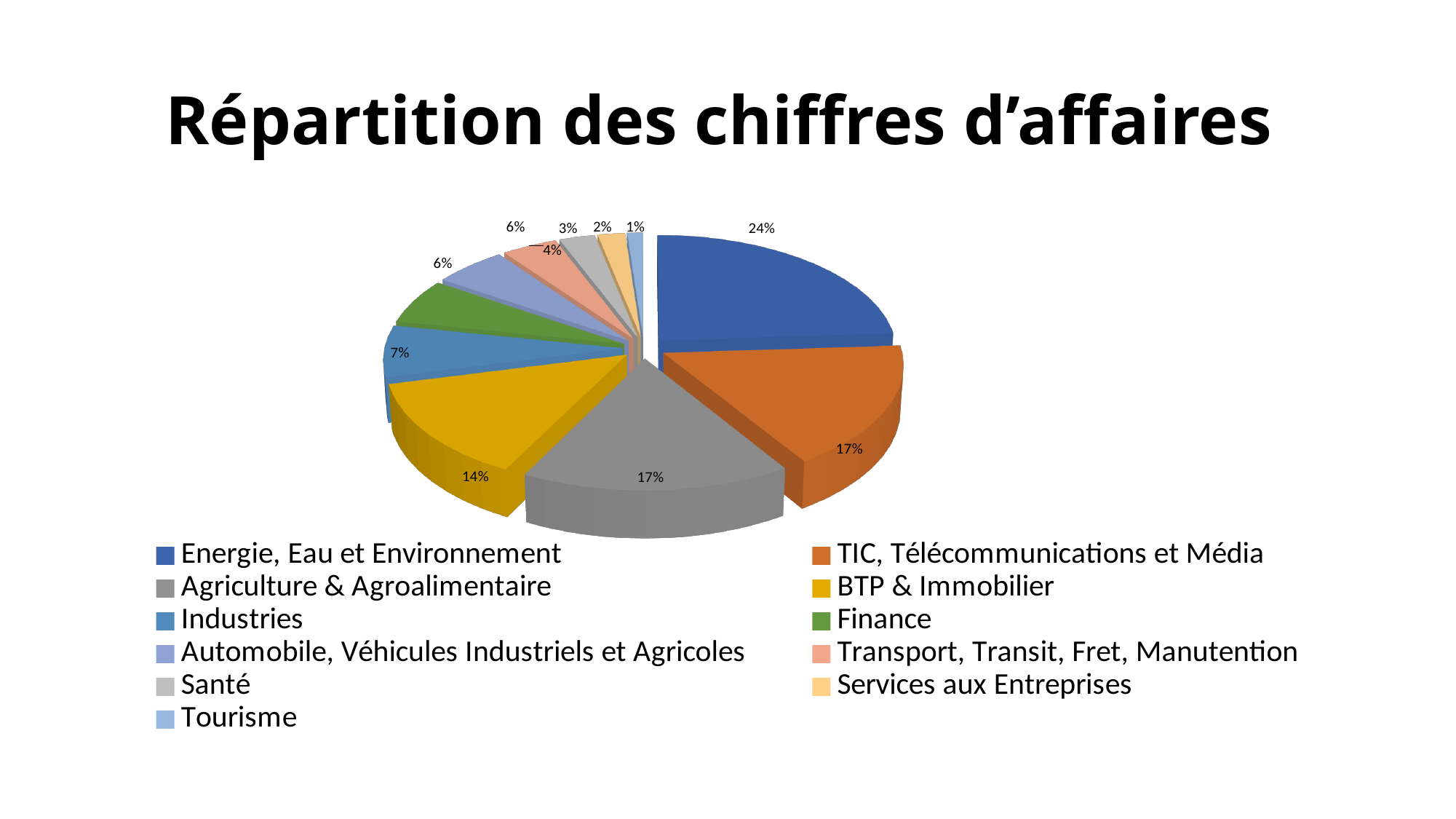
What share of the pie does Energie, Eau et Environnement represent? 24% What type of chart is shown on the slide? pie chart Which is larger, the share for Industries or the share for Santé? Industries What is the value shown for Industries? 7% What is the difference between the shares of Energie, Eau et Environnement and BTP & Immobilier? 10% Which category has the smallest share of the pie? Tourisme Which category has the largest share of the pie? Energie, Eau et Environnement What colour is the slice for Finance? green What is the value shown for Transport, Transit, Fret, Manutention? 4% What is the title of the slide? Répartition des chiffres d’affaires How many categories are shown in the pie chart? 11 What is the value shown for BTP & Immobilier? 14%